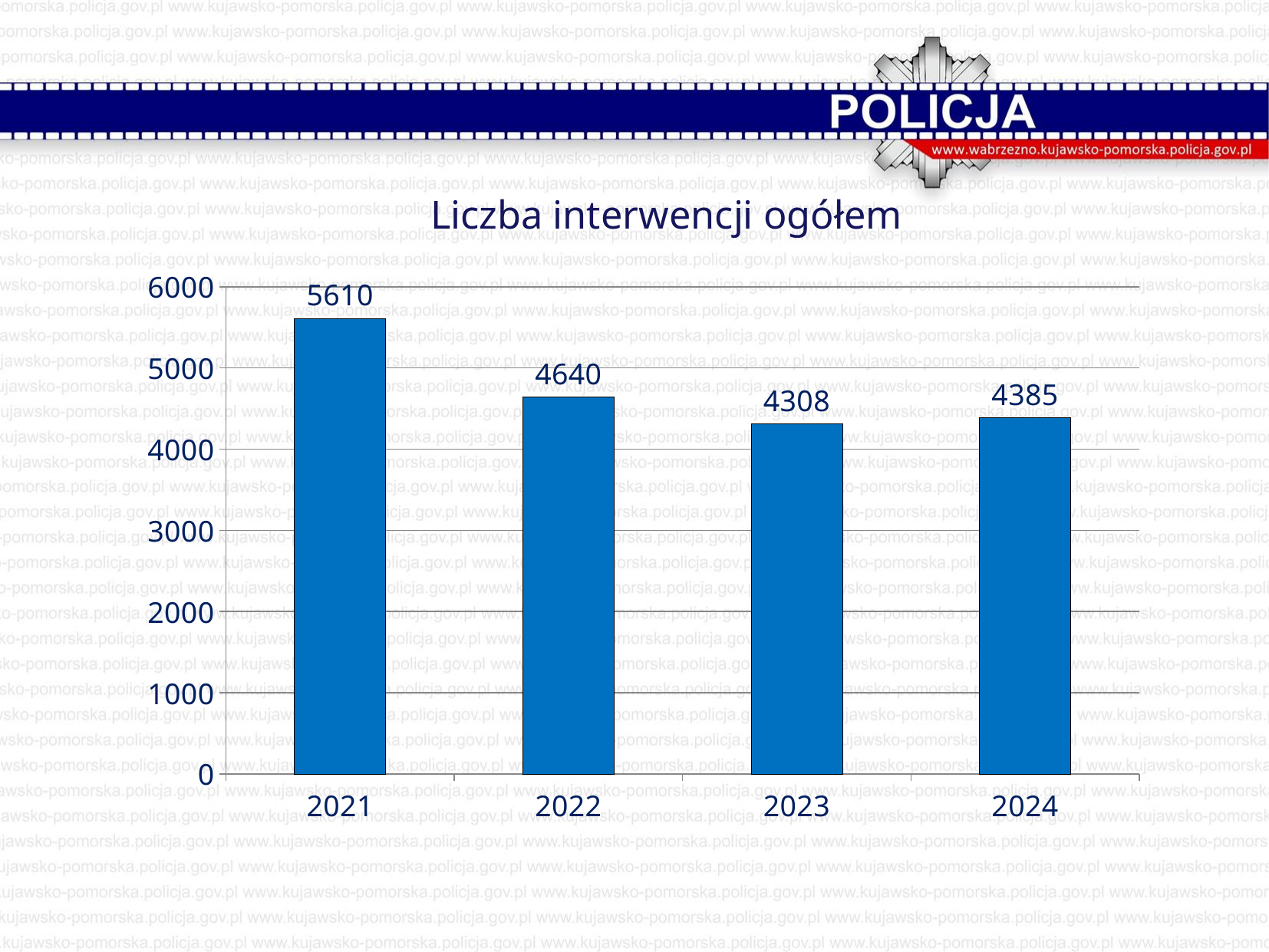
What is the value for 2021? 5610 What kind of chart is shown on the slide? bar chart What is the value for 2022? 4640 Is the value for 2023 greater or less than 5000? less Which is larger, the value for 2022 or the value for 2024? 2022 What is the difference between the values for 2024 and 2023? 77 Which year has the highest number of interventions? 2021 What is the value for 2023? 4308 What is the difference between the values for 2021 and 2022? 970 Which year has the lowest number of interventions? 2023 What is the value for 2024? 4385 How many years are shown on the x axis? 4